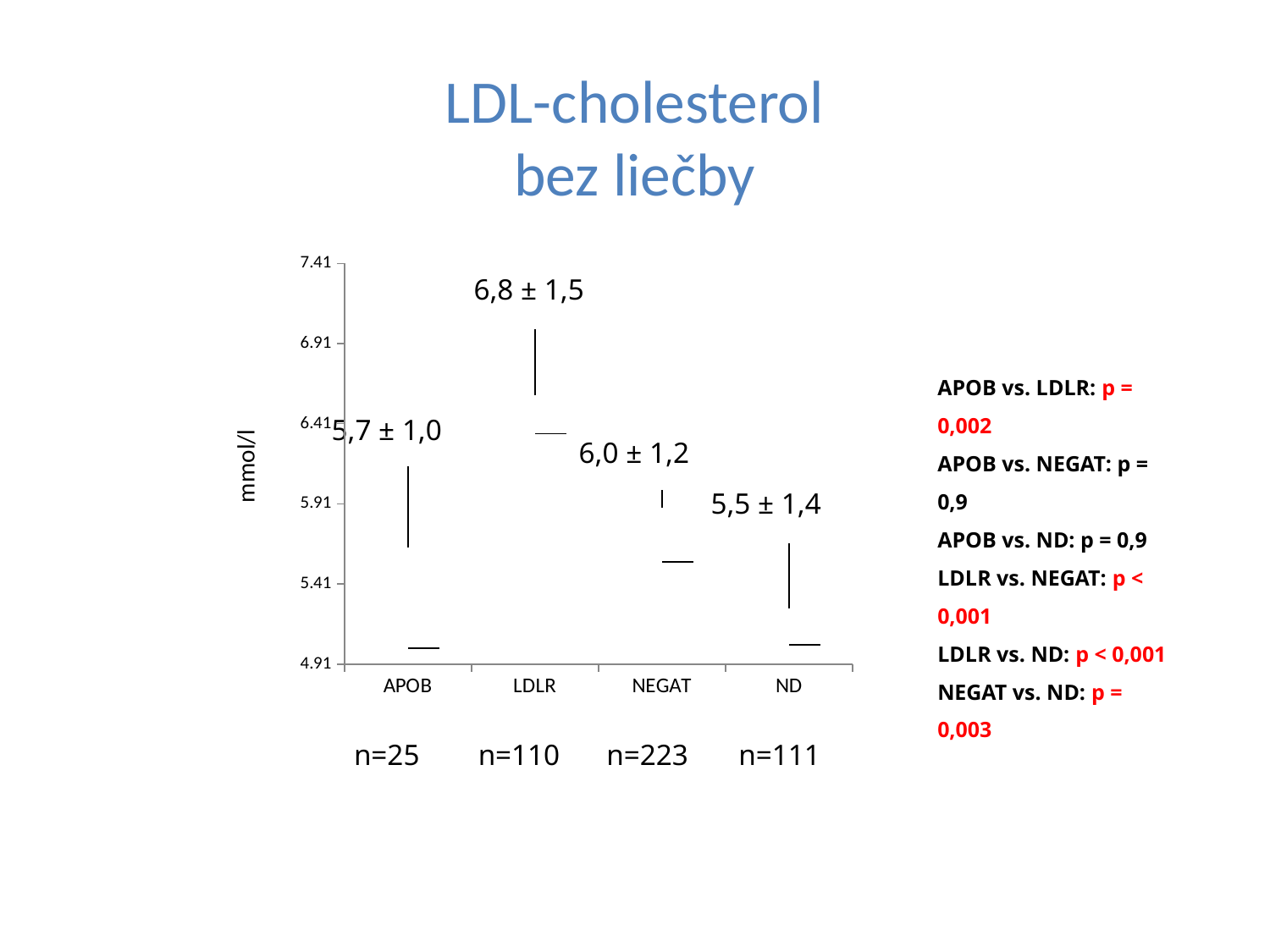
Which group has the highest mean LDL-cholesterol value? LDLR What is the mean LDL-cholesterol value shown for the ND group? 5,5 ± 1,4 What is the mean LDL-cholesterol value shown for the LDLR group? 6,8 ± 1,5 Which group has the lowest mean LDL-cholesterol value? ND Is the mean value for the LDLR group greater or less than 6.41? greater What is the difference between the mean values of the NEGAT and ND groups? 0,5 What is the difference between the mean values of the LDLR and APOB groups? 1,1 What is the title of the slide above the chart? LDL-cholesterol bez liečby How many groups are shown on the x axis of the chart? 4 Which group has the larger mean value, NEGAT or ND? NEGAT What unit is shown on the y axis of the chart? mmol/l What is the sample size (n) given for the NEGAT group? n=223